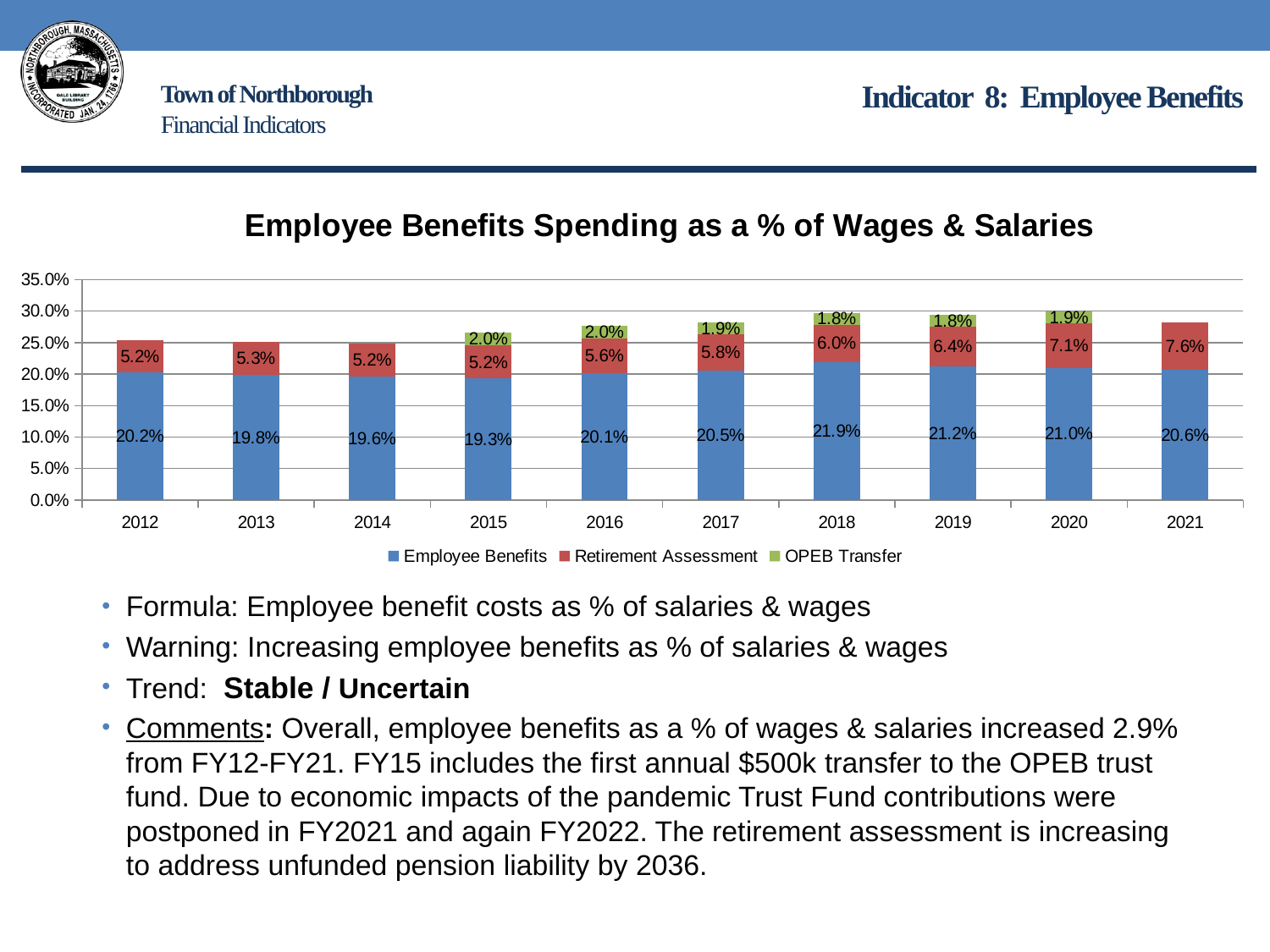
What is the Retirement Assessment value for 2021? 7.6% Which year has the highest Retirement Assessment value? 2021 Which year has the highest Employee Benefits value? 2018 What is the difference between the Retirement Assessment values for 2021 and 2012? 2.4% How many years are shown on the x axis? 10 Is the Retirement Assessment value larger in 2020 or in 2016? 2020 What is the OPEB Transfer value for 2015? 2.0% What is the Employee Benefits value for 2018? 21.9% What type of chart is shown on the slide? Stacked bar chart Which year has the lowest Employee Benefits value? 2015 What is the total of the stacked bar for 2018? 29.7% How many series does the legend list? 3